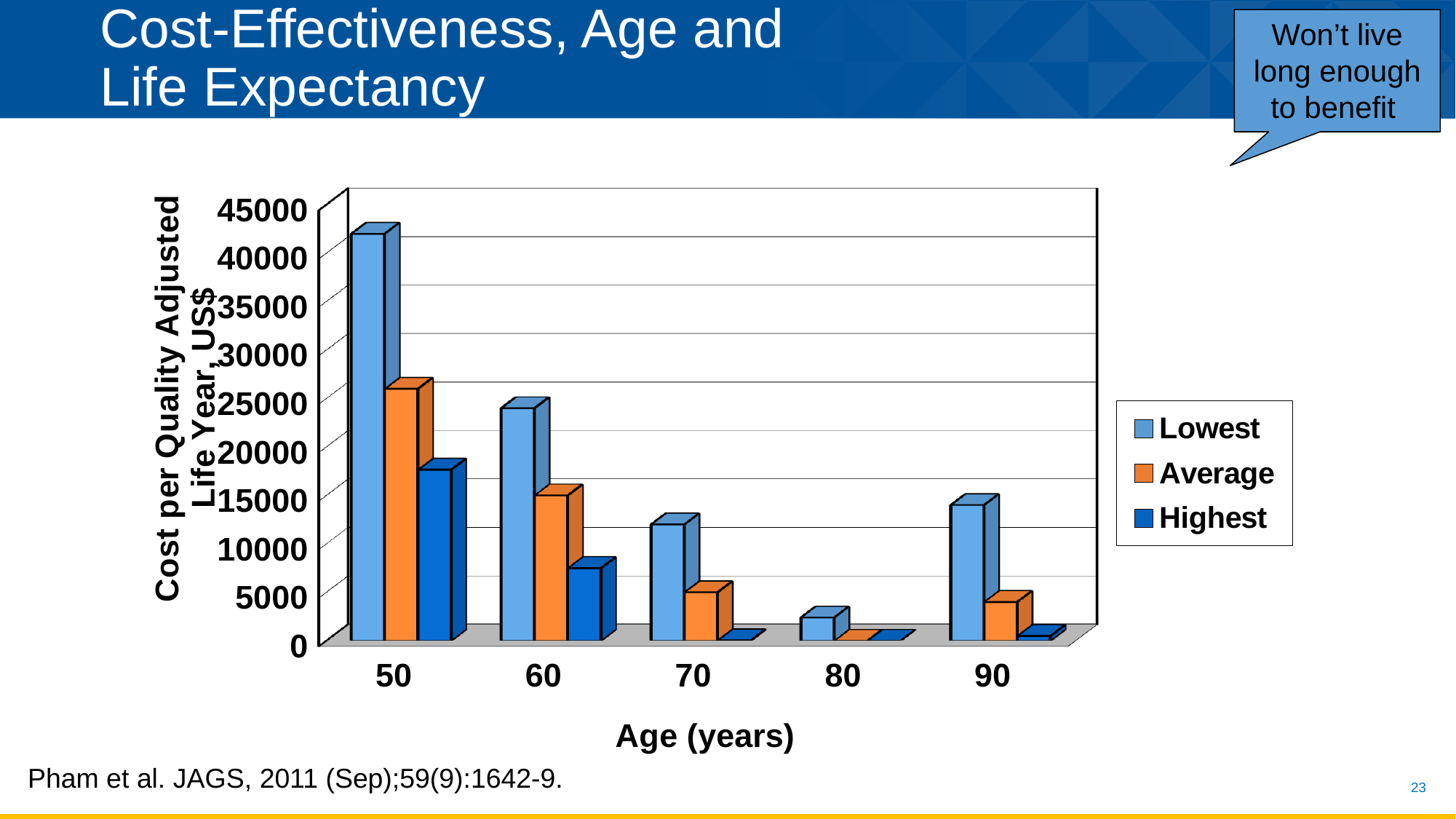
Is the Lowest value at age 70 greater or less than 10000? greater How many series does the legend list? 3 Is the Lowest value at age 80 greater or less than 5000? less Is the Highest value at age 60 greater or less than 10000? less Which is larger, the Lowest value at age 90 or the Lowest value at age 80? age 90 What is the title of the x axis? Age (years) Does the Lowest series rise or fall from age 50 to age 80? falls How many age categories are shown on the x axis? 5 At which age is the Lowest series lowest? 80 What kind of chart is shown on the slide? bar chart At which age is the Lowest series highest? 50